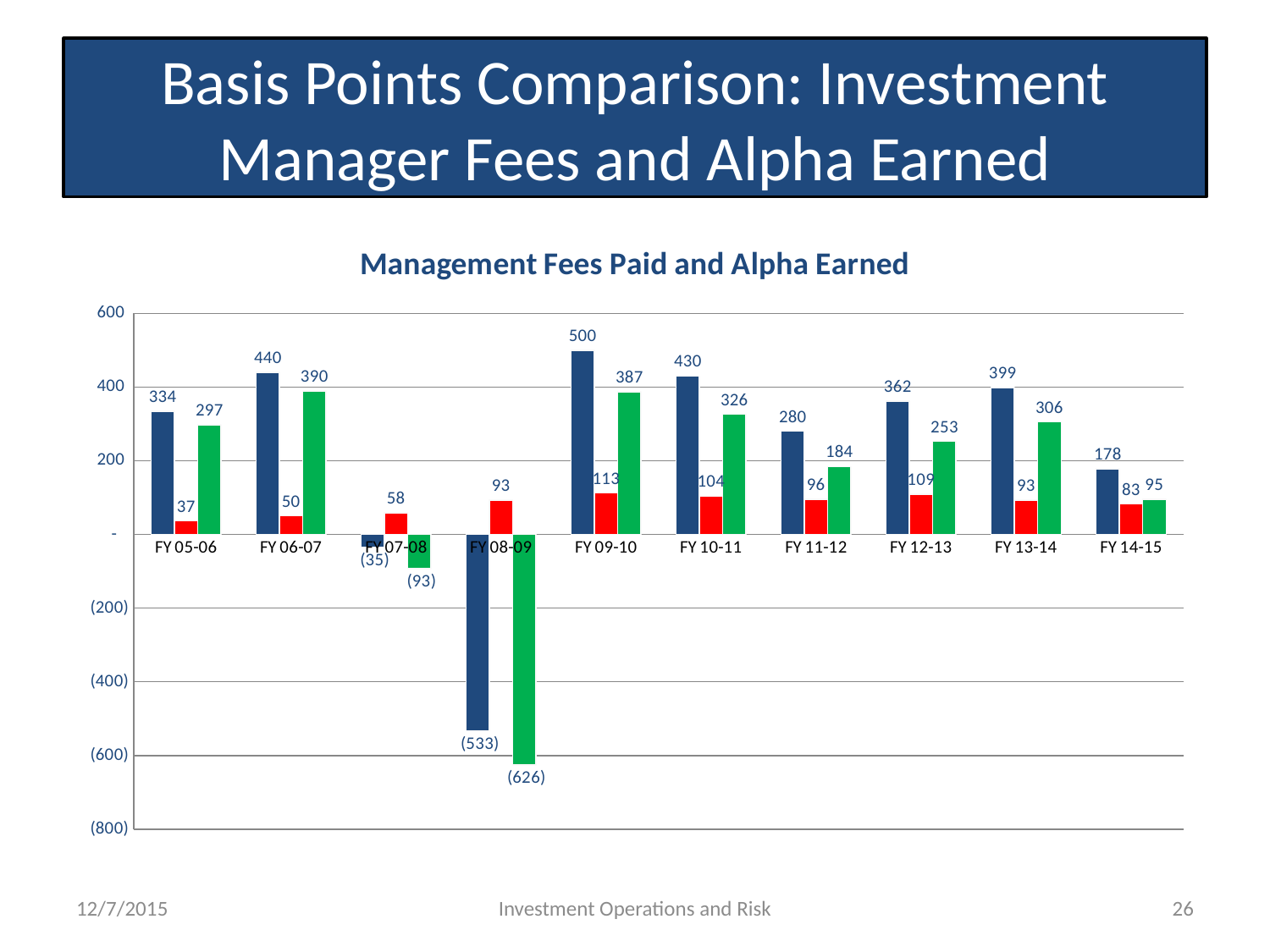
In which fiscal year is the green bar lowest? FY 08-09 What is the value of the green bar for FY 08-09? (626) What is the value of the blue bar for FY 09-10? 500 What is the title of the chart? Management Fees Paid and Alpha Earned Which is larger, the green bar for FY 06-07 or the green bar for FY 13-14? FY 06-07 What is the difference between the blue bar and the green bar for FY 09-10? 113 What is the value of the red bar for FY 12-13? 109 How many fiscal years are shown on the x axis of the chart? 10 Is the value of the blue bar for FY 11-12 greater or less than 200? greater What kind of chart is shown on the slide? bar chart Do the red bars rise or fall from FY 05-06 to FY 09-10? rise In which fiscal year is the blue bar highest? FY 09-10